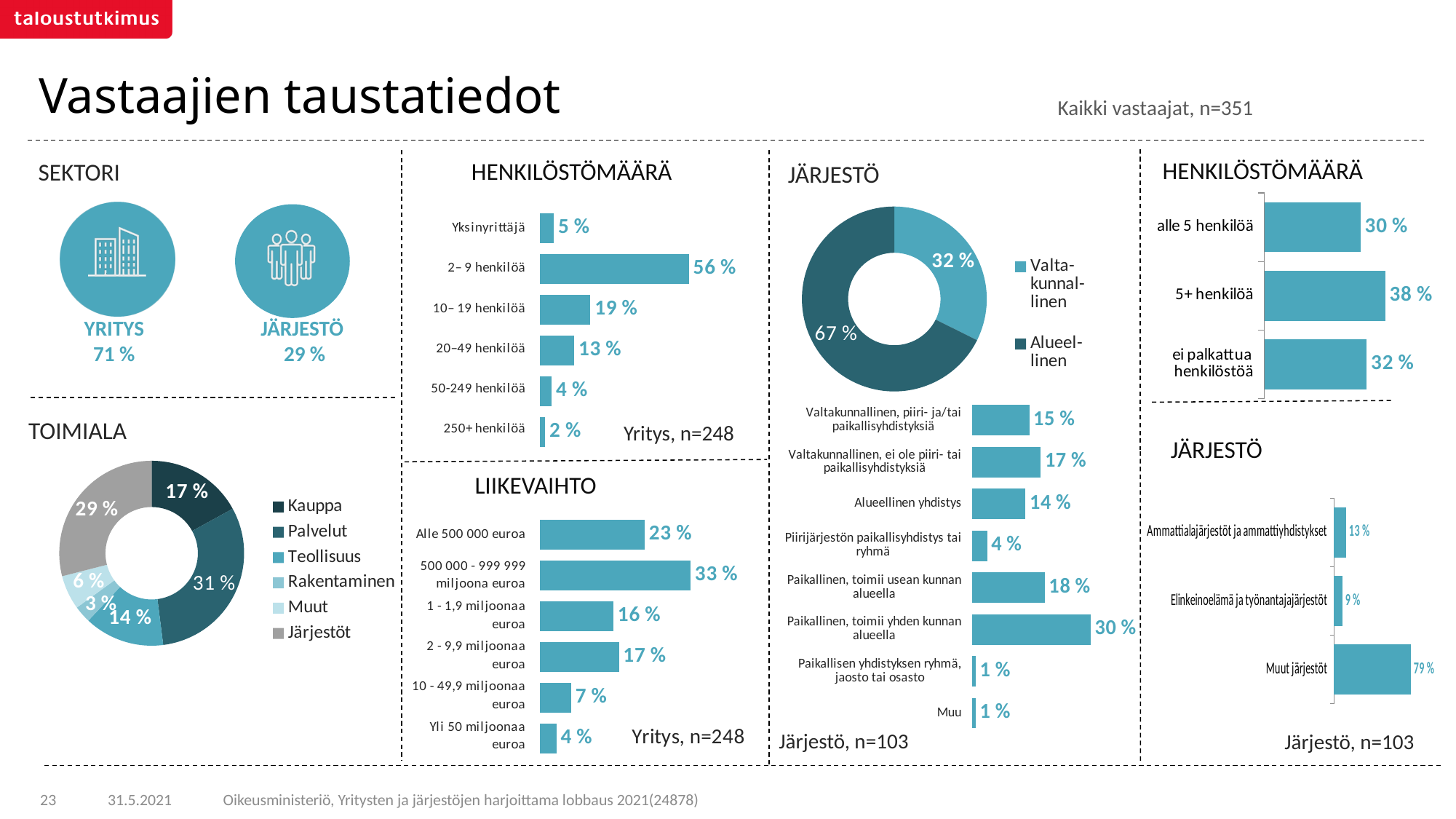
In the LIIKEVAIHTO bar chart, which is larger: 1 - 1,9 miljoonaa euroa or 2 - 9,9 miljoonaa euroa? 2 - 9,9 miljoonaa euroa What type of chart is the JÄRJESTÖ chart at the bottom right of the slide? Bar chart In the TOIMIALA donut chart, what share is Palvelut? 31 % In the TOIMIALA donut chart, which category has the smallest share? Rakentaminen In the JÄRJESTÖ bar chart in the middle of the slide (Järjestö, n=103), which category has the highest value? Paikallinen, toimii yhden kunnan alueella How many categories are shown in the LIIKEVAIHTO bar chart? 6 In the HENKILÖSTÖMÄÄRÄ bar chart for Yritys (n=248), what is the value for 10– 19 henkilöä? 19 % In the HENKILÖSTÖMÄÄRÄ bar chart for Yritys (n=248), which category has the highest value? 2– 9 henkilöä In the LIIKEVAIHTO bar chart, what is the difference between the values for 500 000 - 999 999 miljoona euroa and Alle 500 000 euroa? 10 % In the HENKILÖSTÖMÄÄRÄ bar chart on the right (Järjestö, n=103), what is the value for 5+ henkilöä? 38 % How many categories does the legend of the TOIMIALA donut chart list? 6 In the JÄRJESTÖ donut chart in the middle of the slide, what share is Alueellinen? 67 %